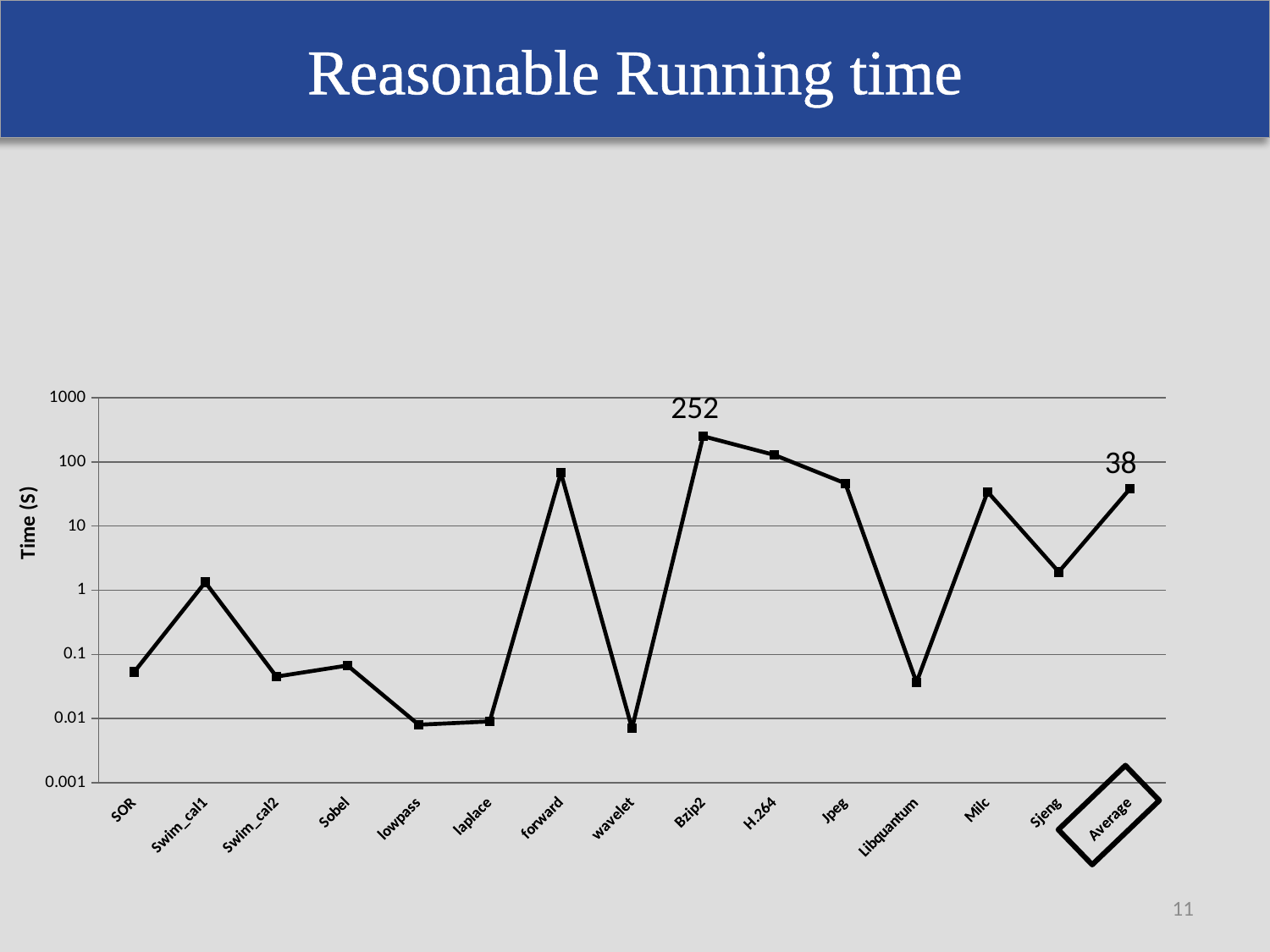
What is the difference between the labelled values for Bzip2 and Average? 214 What type of chart is shown on the slide? line chart What is the title of the slide containing the chart? Reasonable Running time What is the running time value labelled for Bzip2? 252 Is the value for Libquantum greater or less than 0.1? less Which has a larger running time, forward or Sobel? forward What is the value labelled for Average? 38 What is the label of the y axis? Time (S) Is the value for forward greater or less than 10? greater How many categories are plotted along the x axis? 15 Is the value for Jpeg greater or less than 100? less Which category has the highest running time? Bzip2